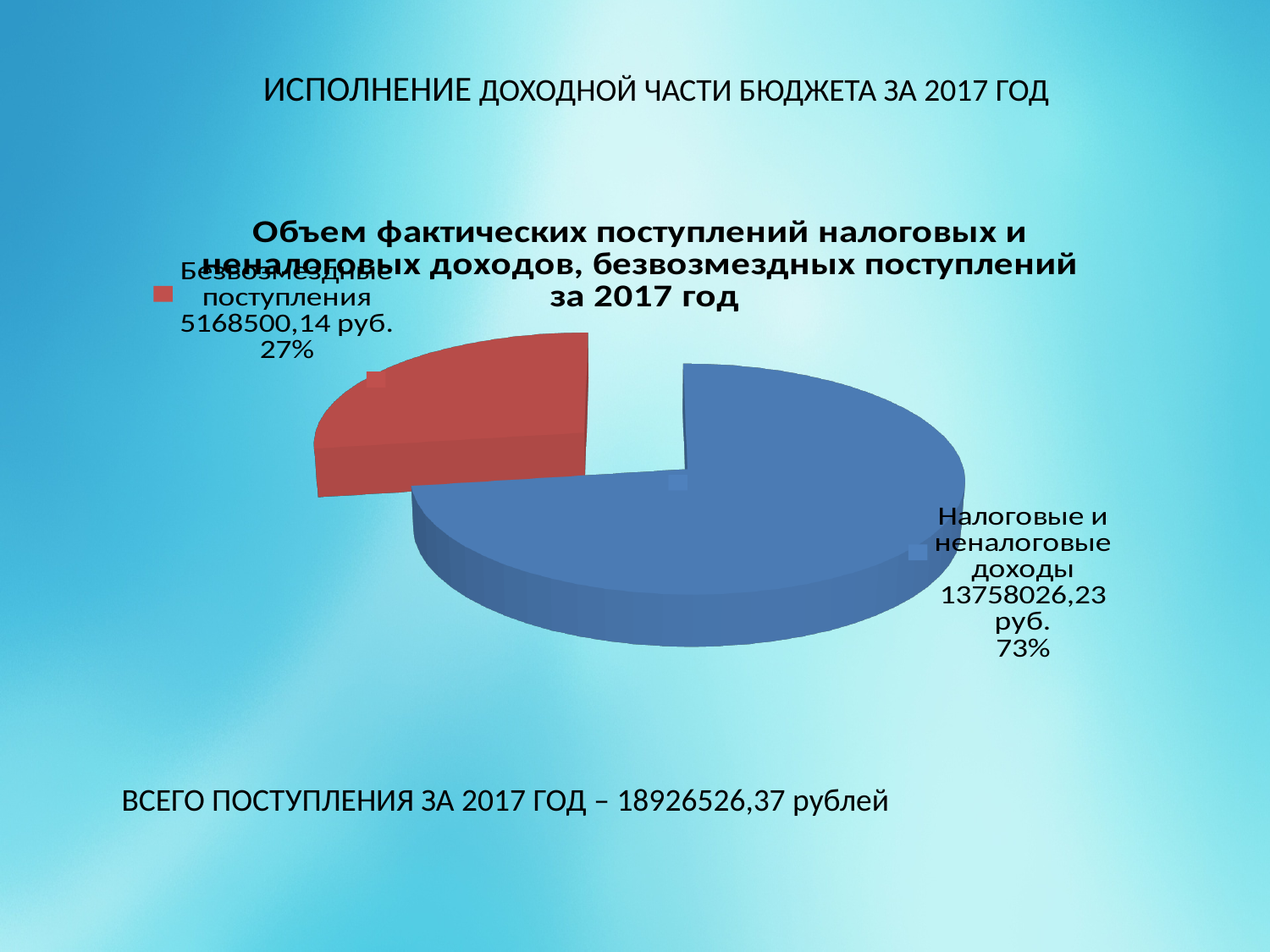
What share of the pie does Безвозмездные поступления represent? 27% What is the difference in percentage points between the share of Налоговые и неналоговые доходы and the share of Безвозмездные поступления? 46 percentage points Which is larger: Налоговые и неналоговые доходы or Безвозмездные поступления? Налоговые и неналоговые доходы What colour is the slice for Безвозмездные поступления? red What is the value shown for Налоговые и неналоговые доходы? 13758026,23 руб. What kind of chart is shown on the slide? pie chart What is the value shown for Безвозмездные поступления? 5168500,14 руб. Which slice of the pie chart is the smallest? Безвозмездные поступления How many slices does the pie chart have? 2 What share of the pie does Налоговые и неналоговые доходы represent? 73% What is the title of the pie chart? Объем фактических поступлений налоговых и неналоговых доходов, безвозмездных поступлений за 2017 год Which slice of the pie chart is the largest? Налоговые и неналоговые доходы